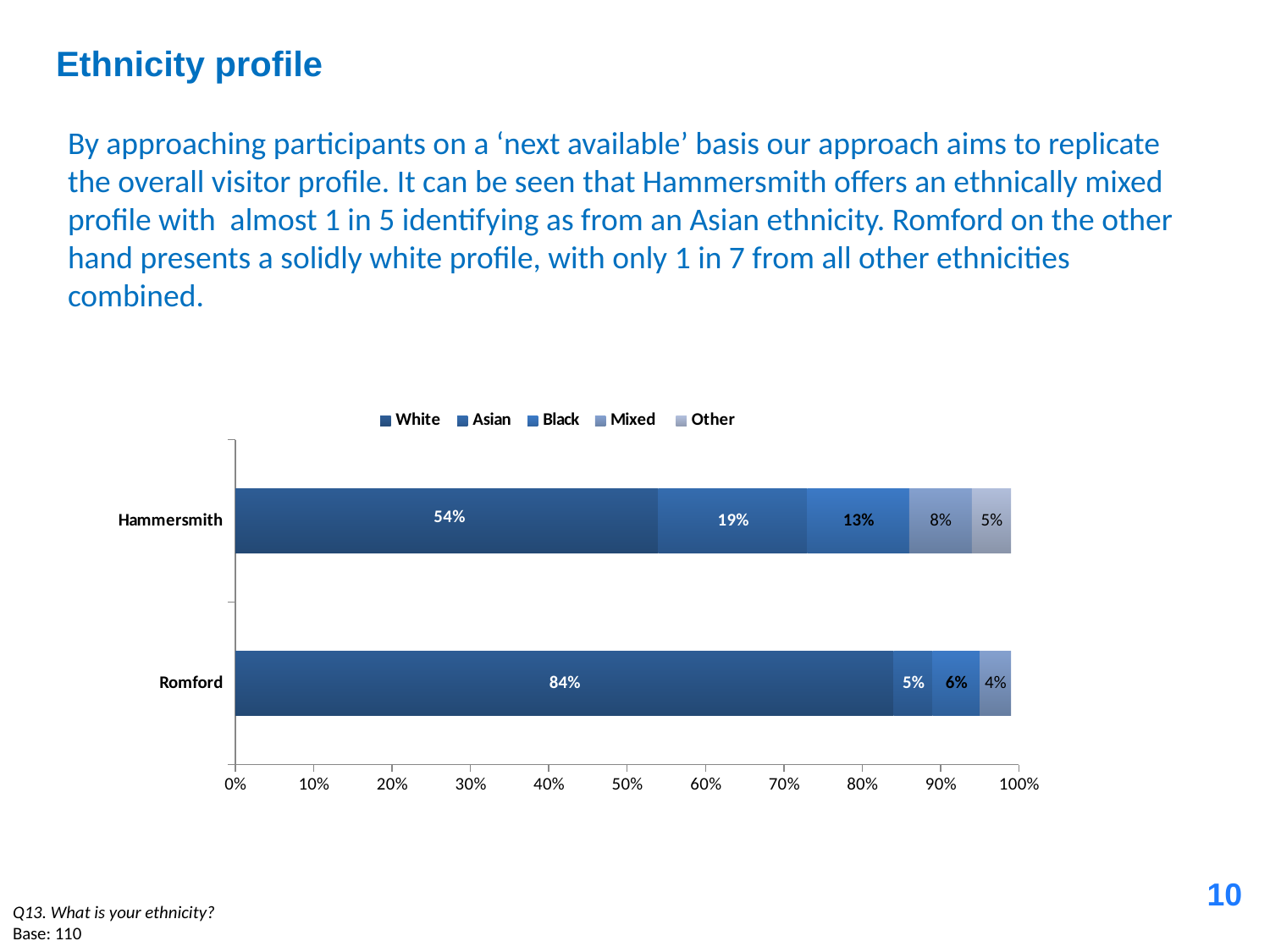
What percentage of Hammersmith visitors identified as Asian? 19% Which location has the highest White share? Romford How many ethnicity series does the legend list? 5 What percentage of Romford visitors identified as Black? 6% How many percentage points higher is the White share in Romford than in Hammersmith? 30 percentage points What percentage of Hammersmith visitors identified as White? 54% Which location has the larger Asian share, Hammersmith or Romford? Hammersmith How many locations are shown on the chart? 2 What percentage of Hammersmith visitors identified as Mixed? 8% What type of chart is used to show the ethnicity profile? Stacked bar chart What percentage of Romford visitors identified as White? 84% Is the White share for Romford greater or less than 80%? greater